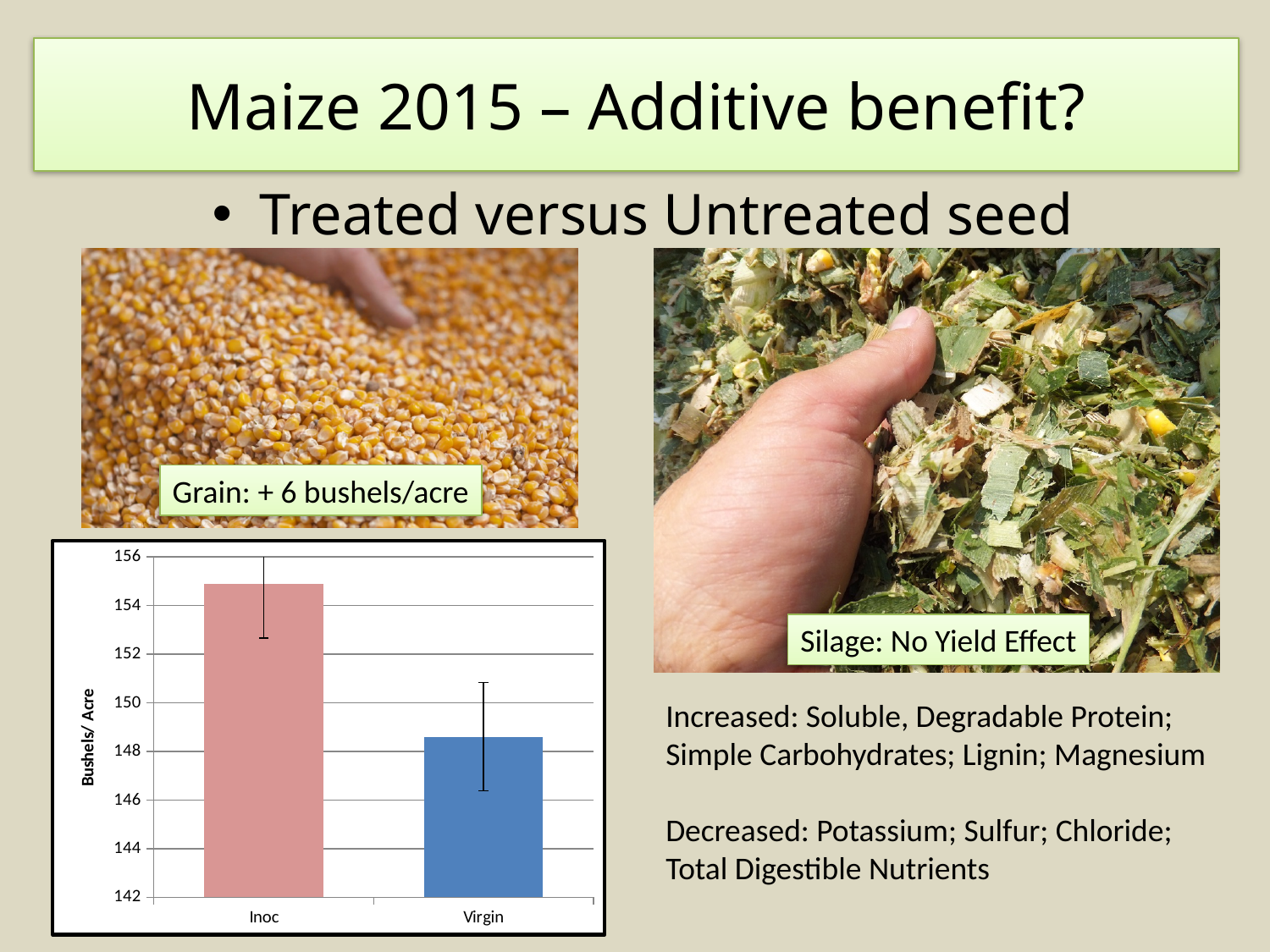
Which category has the lowest value on the bar chart? Virgin Is the value for Inoc greater or less than 156? less What is the label on the vertical axis of the bar chart? Bushels/ Acre What kind of chart is shown on the slide? bar chart Is the value for Virgin greater or less than 150? less Is the value for Inoc greater or less than 154? greater Which is larger on the bar chart, the value for Inoc or the value for Virgin? Inoc How many categories are plotted on the bar chart? 2 Do the values rise or fall going from Inoc to Virgin along the x axis? fall Which category has the highest value on the bar chart? Inoc What is the lowest value shown on the vertical axis of the bar chart? 142